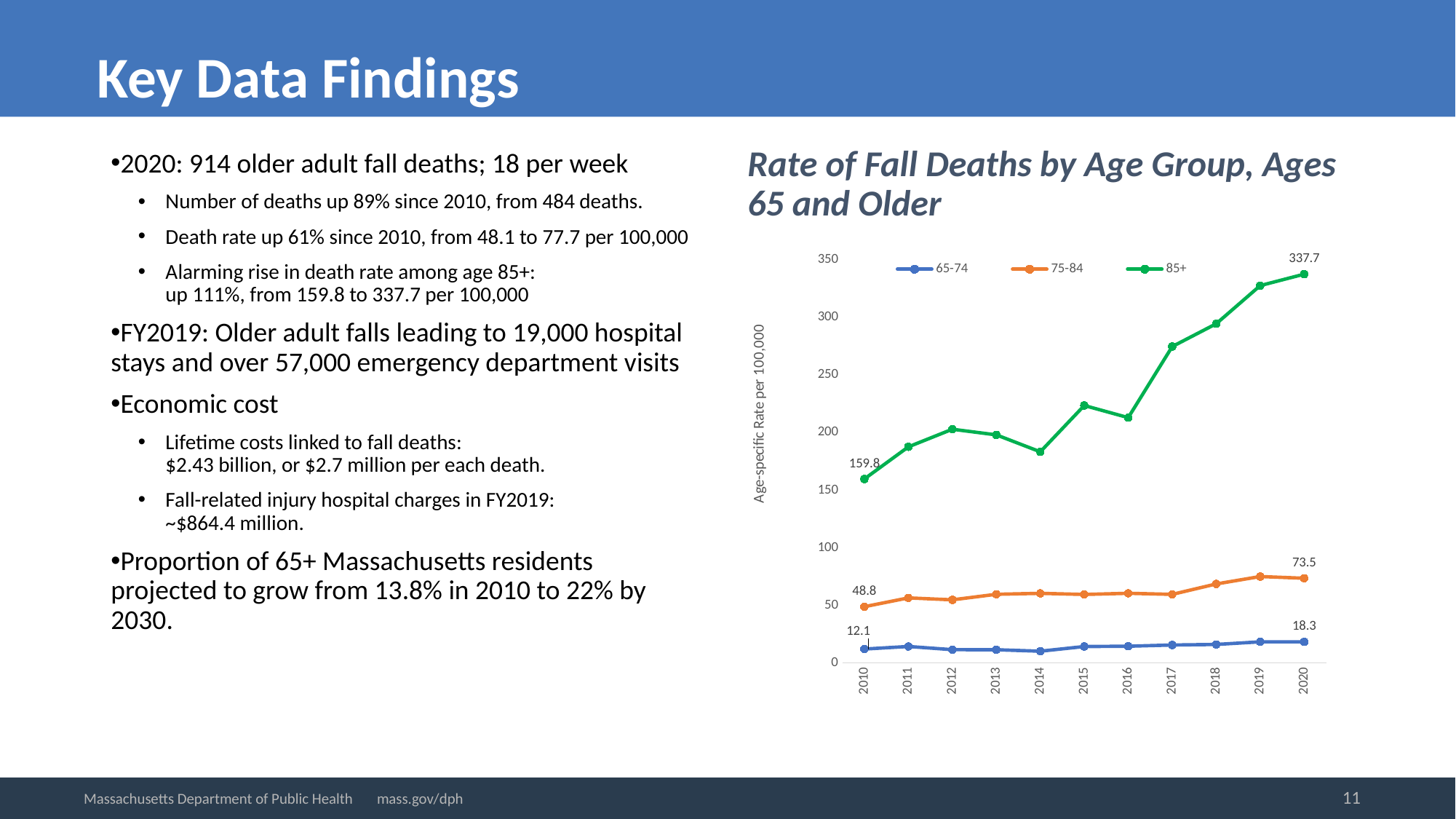
How many series does the legend list? 3 What is the value for the 85+ age group in 2010? 159.8 What is the value for the 85+ age group in 2020? 337.7 What is the difference between the 75-84 rate in 2020 and in 2010? 24.7 What is the value for the 65-74 age group in 2010? 12.1 Which age group has the highest rate in 2020? 85+ What is the value for the 75-84 age group in 2020? 73.5 By how much did the rate for the 85+ age group increase from 2010 to 2020? 177.9 What kind of chart is shown? line chart How many years are plotted on the x axis? 11 Which age group has the lowest rate in 2010? 65-74 Is the value for the 85+ age group in 2014 greater or less than 200? less